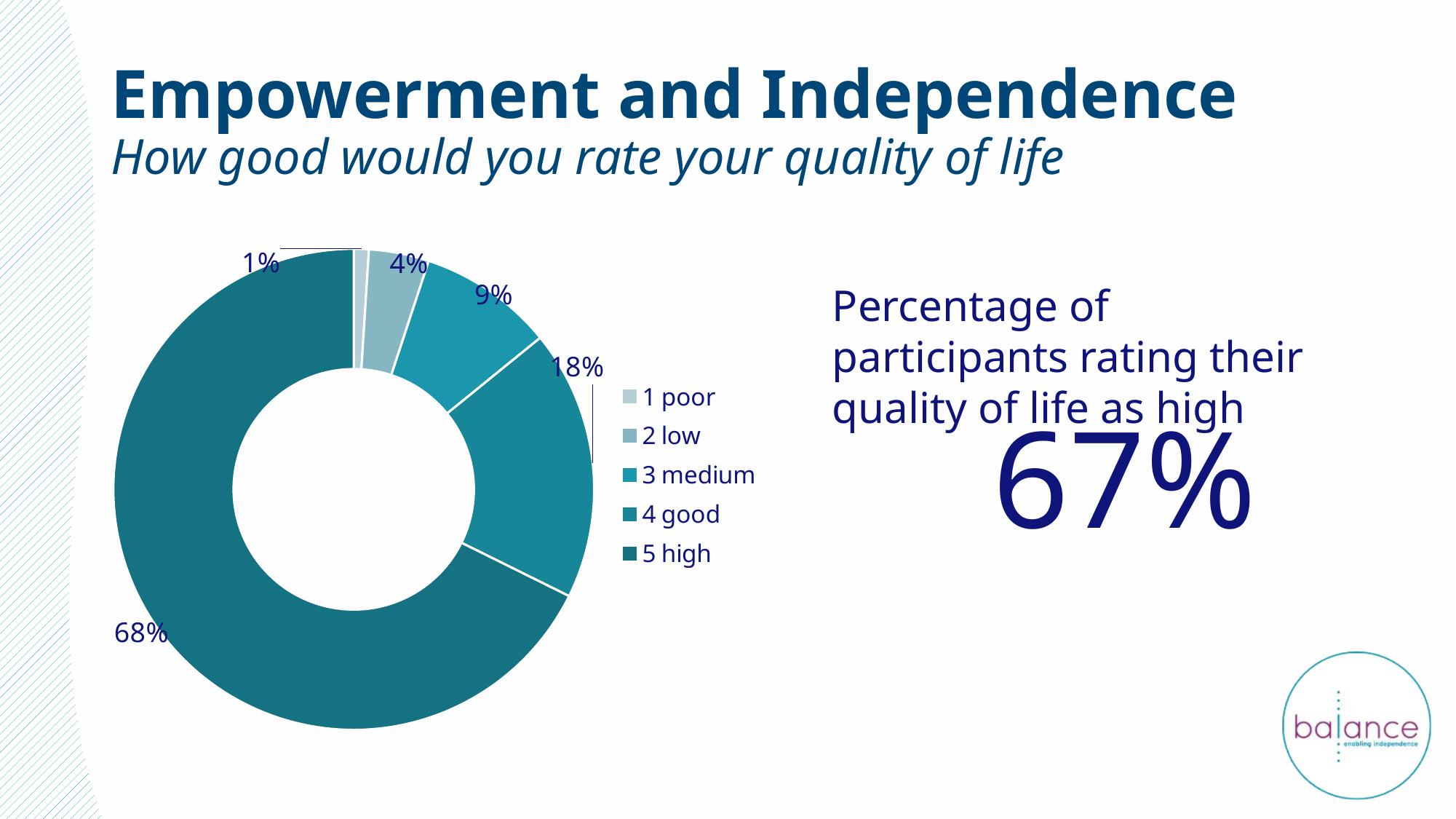
What percentage of participants rated their quality of life as 4 good? 18% What is the combined percentage for the 4 good and 5 high categories? 86% What percentage of participants rated their quality of life as 1 poor? 1% Which rating category has the smallest share of the chart? 1 poor What kind of chart is shown on the slide? Doughnut chart What percentage of participants rated their quality of life as 5 high? 68% How many rating categories are shown in the chart? 5 What is the difference in percentage points between the 5 high and 4 good categories? 50 Which is larger, the share for 3 medium or the share for 2 low? 3 medium What percentage of participants rated their quality of life as 3 medium? 9% What percentage of participants rated their quality of life as 2 low? 4% Which rating category has the largest share of the chart? 5 high